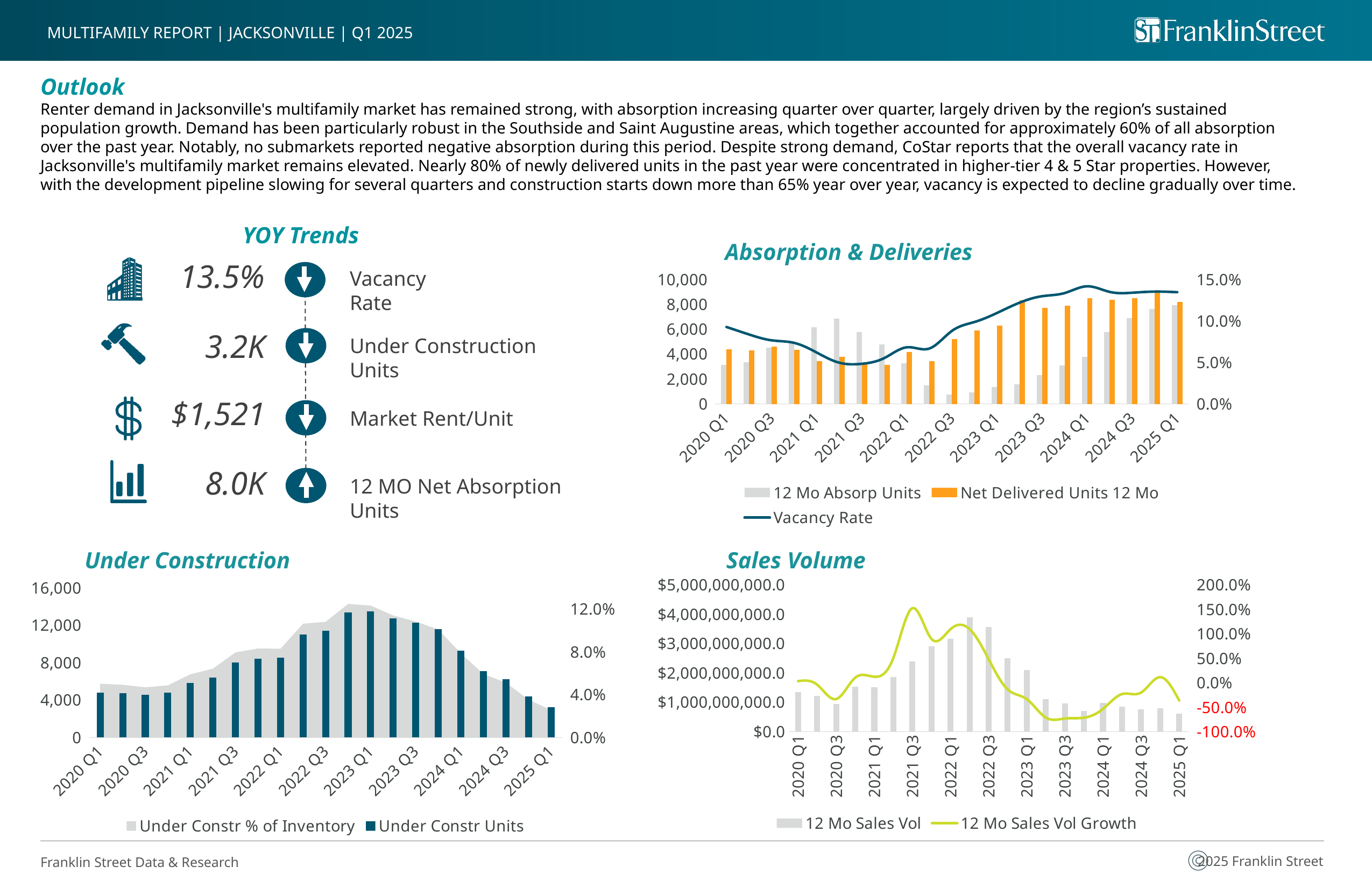
In the Absorption & Deliveries chart, how many series does the legend list? 3 In the Sales Volume chart, which quarter has the highest 12 Mo Sales Vol? 2022 Q2 In the Under Construction chart, is the Under Constr Units value for 2025 Q1 greater or less than 4,000? less In the Under Construction chart, which quarter has the lowest Under Constr Units value? 2025 Q1 In the Sales Volume chart, is the 12 Mo Sales Vol Growth for 2021 Q3 greater or less than 100.0%? greater What kind of chart is the Sales Volume chart? bar chart with a line In the Absorption & Deliveries chart, is the 12 Mo Absorp Units value for 2025 Q1 greater or less than 6,000? greater In the Under Construction chart, which is larger, the Under Constr Units value for 2020 Q1 or for 2025 Q1? 2020 Q1 In the Absorption & Deliveries chart, does the Vacancy Rate line end higher or lower in 2025 Q1 than it started in 2020 Q1? higher